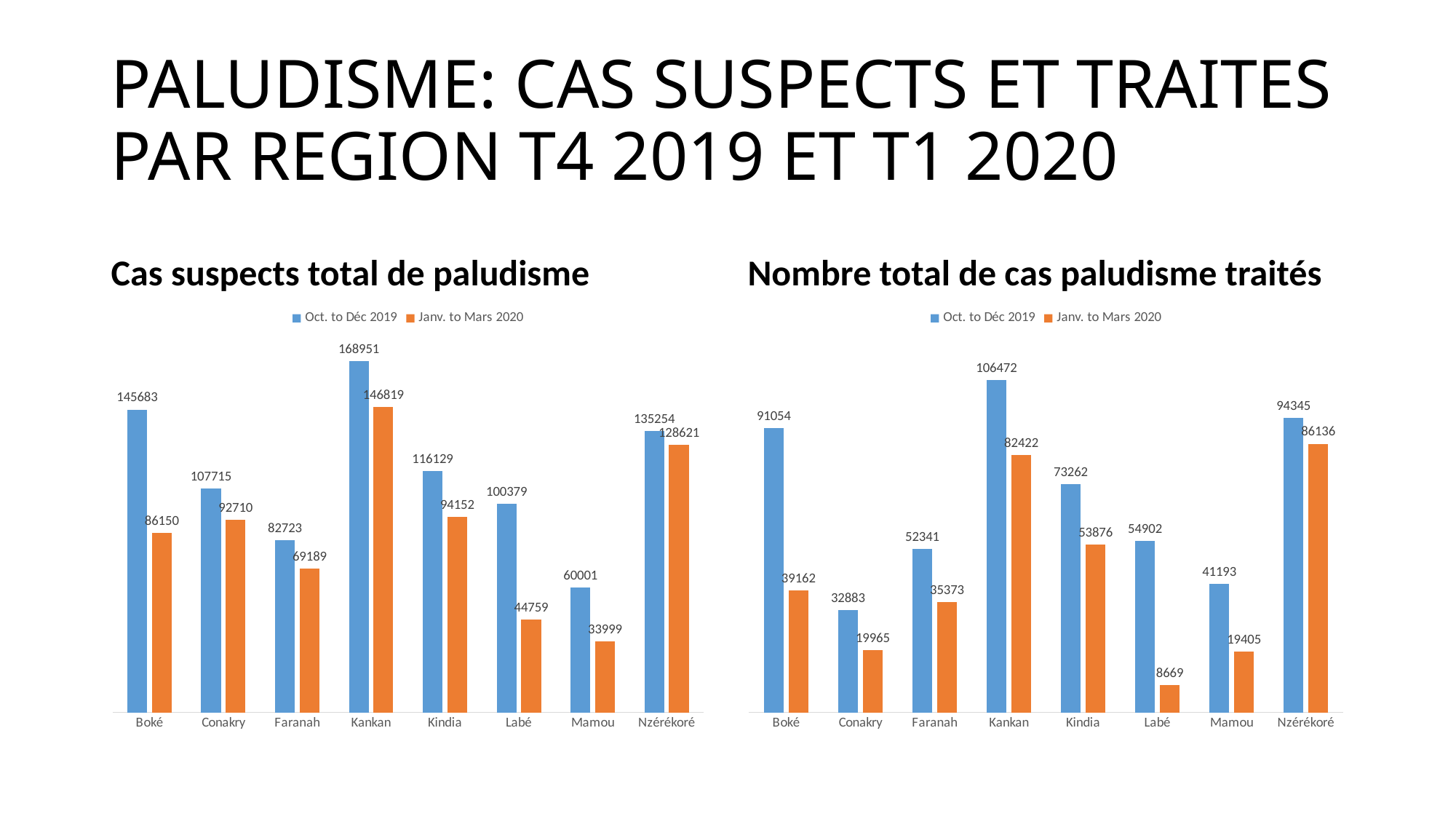
In the 'Cas suspects total de paludisme' chart, what is the difference between the Oct. to Déc 2019 and Janv. to Mars 2020 values for Boké? 59533 What kind of chart is the 'Cas suspects total de paludisme' chart? Bar chart In the 'Nombre total de cas paludisme traités' chart, what is the difference between the Oct. to Déc 2019 and Janv. to Mars 2020 values for Kankan? 24050 In the 'Nombre total de cas paludisme traités' chart, which is larger for Kindia: Oct. to Déc 2019 or Janv. to Mars 2020? Oct. to Déc 2019 In the 'Nombre total de cas paludisme traités' chart, which region has the lowest value for Janv. to Mars 2020? Labé In the 'Cas suspects total de paludisme' chart, what is the value for Labé in Janv. to Mars 2020? 44759 In the 'Nombre total de cas paludisme traités' chart, which colour represents Janv. to Mars 2020? Orange In the 'Cas suspects total de paludisme' chart, which region has the highest value for Oct. to Déc 2019? Kankan How many regions are shown on the x axis of the 'Cas suspects total de paludisme' chart? 8 In the 'Nombre total de cas paludisme traités' chart, what is the value for Nzérékoré in Janv. to Mars 2020? 86136 How many series does the legend of the 'Nombre total de cas paludisme traités' chart list? 2 In the 'Cas suspects total de paludisme' chart, what is the value for Kankan in Oct. to Déc 2019? 168951